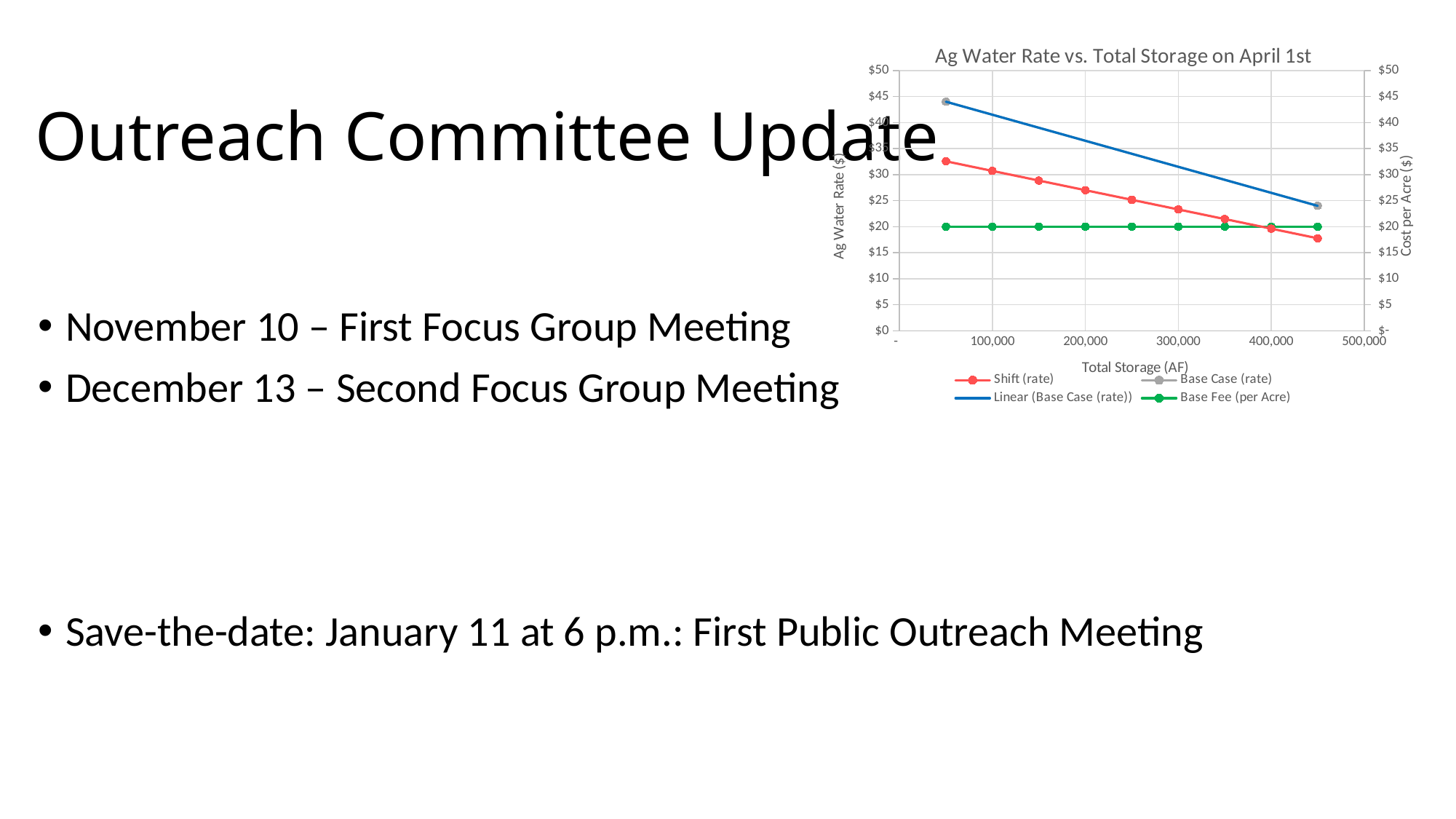
What is the value of the Base Fee (per Acre) series across all storage levels? $20 What is the title of the chart? Ag Water Rate vs. Total Storage on April 1st Is the Base Case (rate) value at 50,000 AF greater or less than $40? greater Is the Shift (rate) value at 50,000 AF greater or less than $30? greater At 50,000 AF, which is larger: the Base Case (rate) or the Shift (rate)? Base Case (rate) How many data points are plotted for the Shift (rate) series? 9 Does the Shift (rate) series rise or fall as Total Storage increases? falls What kind of chart is shown on the slide? line chart How many series does the chart legend list? 4 What is the label of the x axis of the chart? Total Storage (AF) Is the Shift (rate) value at 450,000 AF greater or less than $20? less How many data points are plotted for the Base Case (rate) series? 2